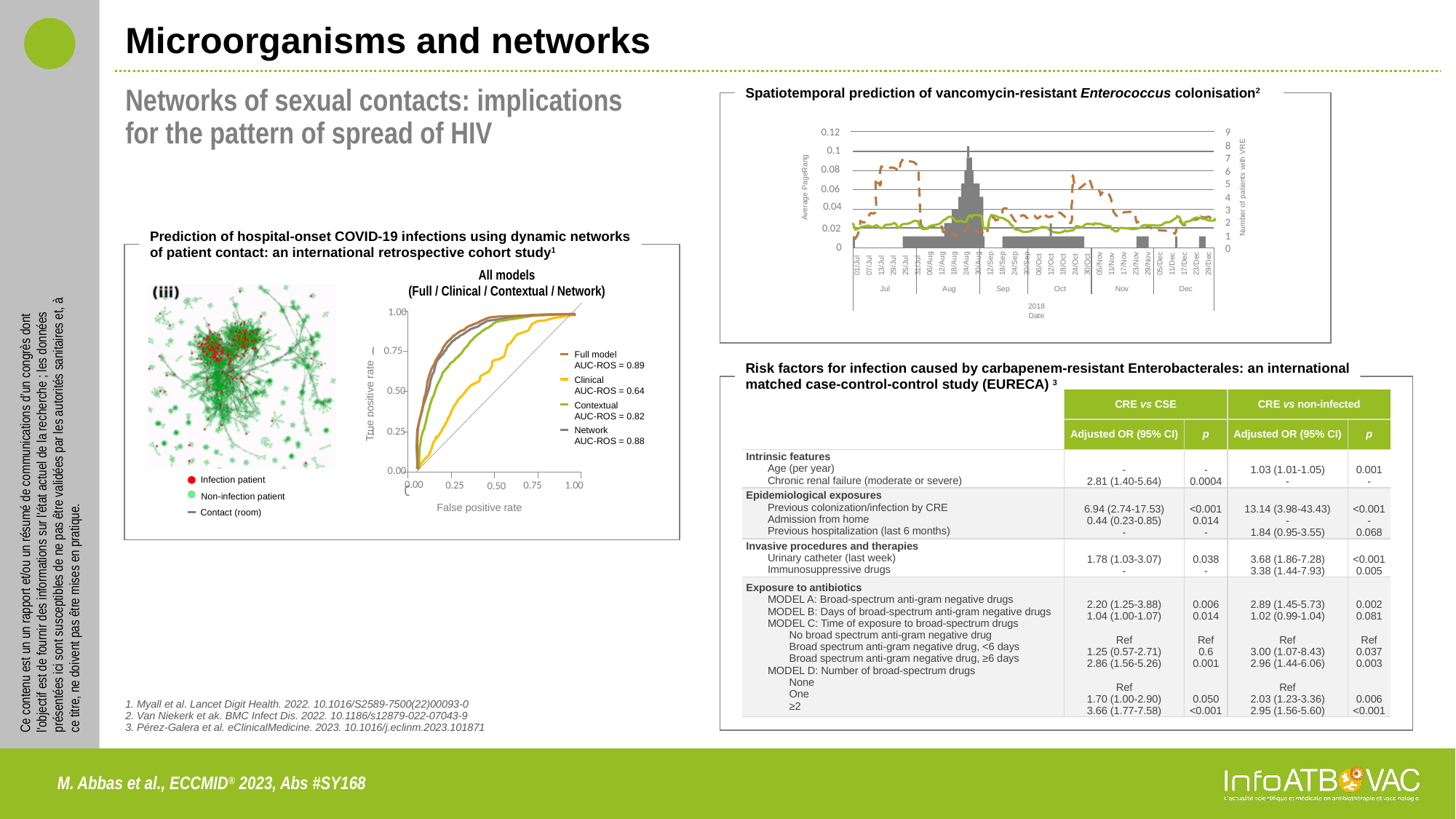
In the 'All models' ROC chart on the left, which model has the highest AUC-ROS? Full model In the 'Spatiotemporal prediction of vancomycin-resistant Enterococcus colonisation' chart, what is the maximum value shown on the right y axis (Number of patients with VRE)? 9 In the 'All models' ROC chart on the left, what is the AUC-ROS value for the Full model? 0.89 In the 'Spatiotemporal prediction of vancomycin-resistant Enterococcus colonisation' chart, is the peak of the orange dashed line in July greater or less than 0.06? greater What is the label of the x axis of the 'All models' ROC chart on the left? False positive rate In the 'Spatiotemporal prediction of vancomycin-resistant Enterococcus colonisation' chart, what is the label of the left y axis? Average PageRank In the 'All models' ROC chart on the left, which model has the lowest AUC-ROS? Clinical In the 'All models' ROC chart on the left, what is the AUC-ROS value for the Network model? 0.88 In the 'All models' ROC chart on the left, what is the AUC-ROS value for the Clinical model? 0.64 In the 'All models' ROC chart on the left, what is the difference between the AUC-ROS of the Full model and the Clinical model? 0.25 How many models does the legend of the 'All models' ROC chart on the left list? 4 In the 'All models' ROC chart on the left, which has a higher AUC-ROS, Contextual or Network? Network